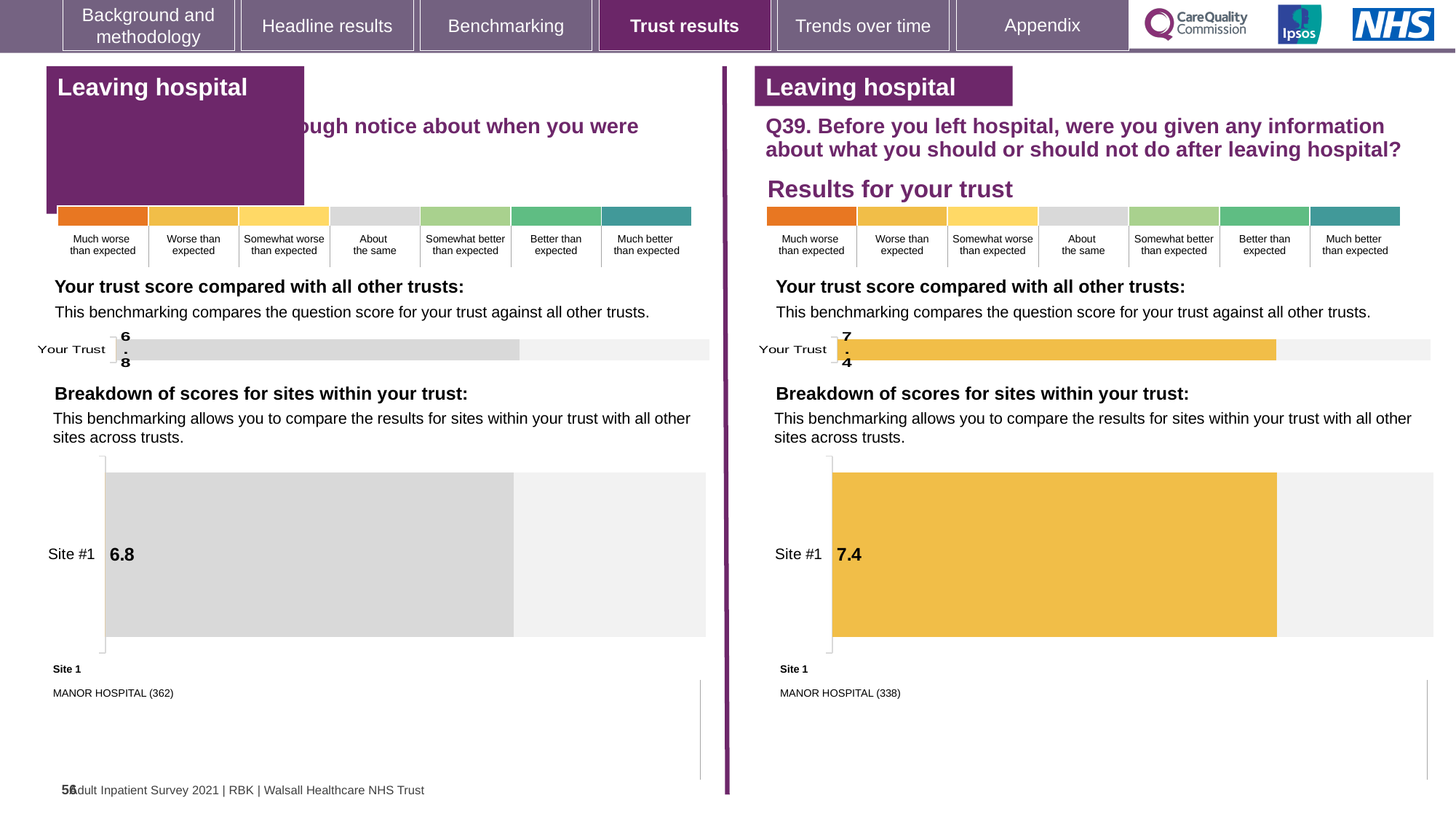
What kind of chart is used to show the Site #1 score on the right-hand side of the slide (Q39)? bar chart How many rating categories are listed in the colour key above the right-hand charts (Q39)? 7 How many sites are shown in the right-hand 'Breakdown of scores for sites within your trust' chart (Q39)? 1 According to the colour key, which rating category does the yellow Your Trust bar on the right-hand chart (Q39) correspond to? Worse than expected Which hospital is listed as Site 1 beneath the right-hand breakdown chart (Q39)? MANOR HOSPITAL (338) On the left-hand 'Your trust score compared with all other trusts' chart, what is the score shown for Your Trust? 6.8 On the right-hand 'Your trust score compared with all other trusts' chart (Q39), what is the score shown for Your Trust? 7.4 On the right-hand 'Breakdown of scores for sites within your trust' chart (Q39), what is the score for Site #1? 7.4 Which Site #1 score is larger: the one on the left-hand breakdown chart or the one on the right-hand breakdown chart (Q39)? the right-hand chart On the left-hand 'Breakdown of scores for sites within your trust' chart, what is the score for Site #1? 6.8 What is the difference between the Your Trust score on the right-hand chart (Q39) and the Your Trust score on the left-hand chart? 0.6